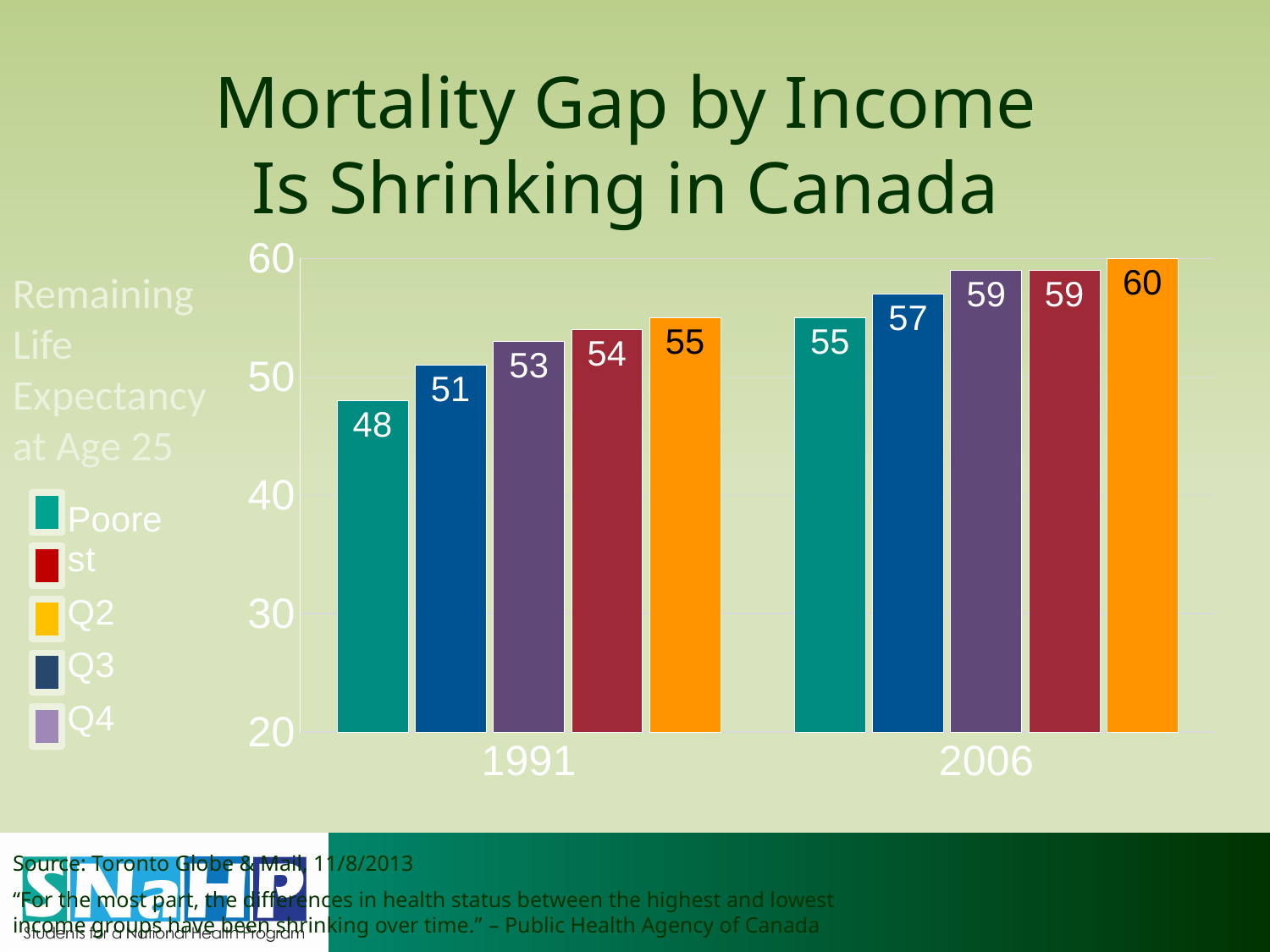
What is the lowest value shown for 2006? 55 What is the value of the orange (rightmost) bar for 2006? 60 What is the highest value shown for 1991? 55 Is the value of the teal bar for 1991 greater or less than 50? less By how much did the teal bar increase from 1991 to 2006? 7 Which year has the larger value for the dark blue bar, 1991 or 2006? 2006 What is the value of the teal (leftmost) bar for 1991? 48 What is the title of the slide? Mortality Gap by Income Is Shrinking in Canada What is the difference between the orange bar and the teal bar for 1991? 7 What kind of chart is shown on the slide? bar chart What is the value of the purple bar for 2006? 59 How many year categories are shown on the x axis? 2